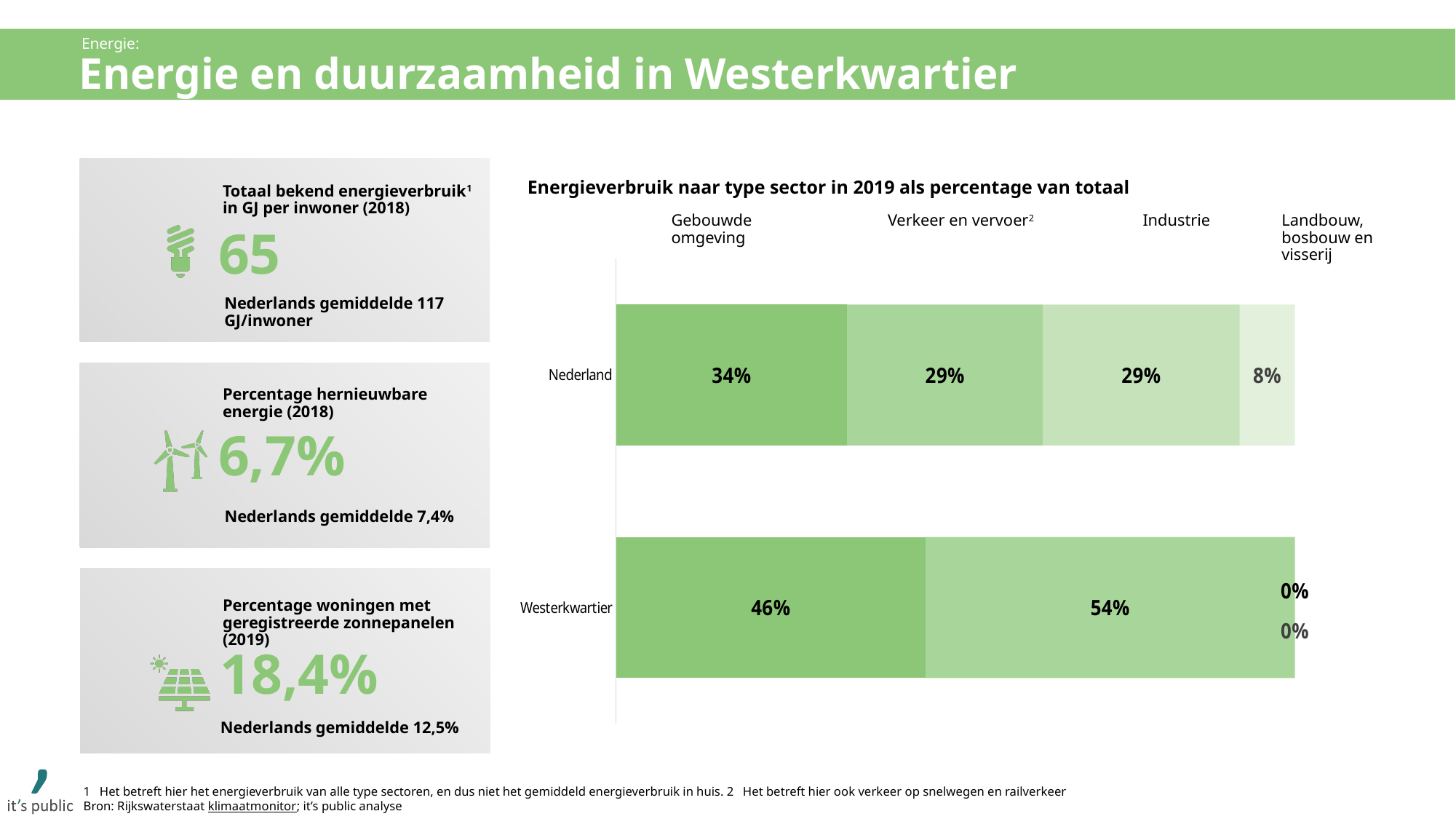
In the chart 'Energieverbruik naar type sector in 2019 als percentage van totaal', what is the value for Industrie for Nederland? 29% In the chart 'Energieverbruik naar type sector in 2019 als percentage van totaal', which sector has the largest share for Westerkwartier? Verkeer en vervoer In the chart 'Energieverbruik naar type sector in 2019 als percentage van totaal', what is the value for Verkeer en vervoer for Westerkwartier? 54% How many regions (bars) are shown in the chart 'Energieverbruik naar type sector in 2019 als percentage van totaal'? 2 In the chart 'Energieverbruik naar type sector in 2019 als percentage van totaal', what is the value for Landbouw, bosbouw en visserij for Nederland? 8% How many sectors (series) are shown in the chart 'Energieverbruik naar type sector in 2019 als percentage van totaal'? 4 In the chart 'Energieverbruik naar type sector in 2019 als percentage van totaal', which is larger: the Verkeer en vervoer share for Nederland or for Westerkwartier? Westerkwartier In the chart 'Energieverbruik naar type sector in 2019 als percentage van totaal', what is the value for Gebouwde omgeving for Nederland? 34% What kind of chart is 'Energieverbruik naar type sector in 2019 als percentage van totaal'? Stacked bar chart In the chart 'Energieverbruik naar type sector in 2019 als percentage van totaal', what is the difference between the Gebouwde omgeving share for Westerkwartier and for Nederland? 12% In the chart 'Energieverbruik naar type sector in 2019 als percentage van totaal', which sector has the smallest share for Nederland? Landbouw, bosbouw en visserij In the chart 'Energieverbruik naar type sector in 2019 als percentage van totaal', what is the value for Industrie for Westerkwartier? 0%